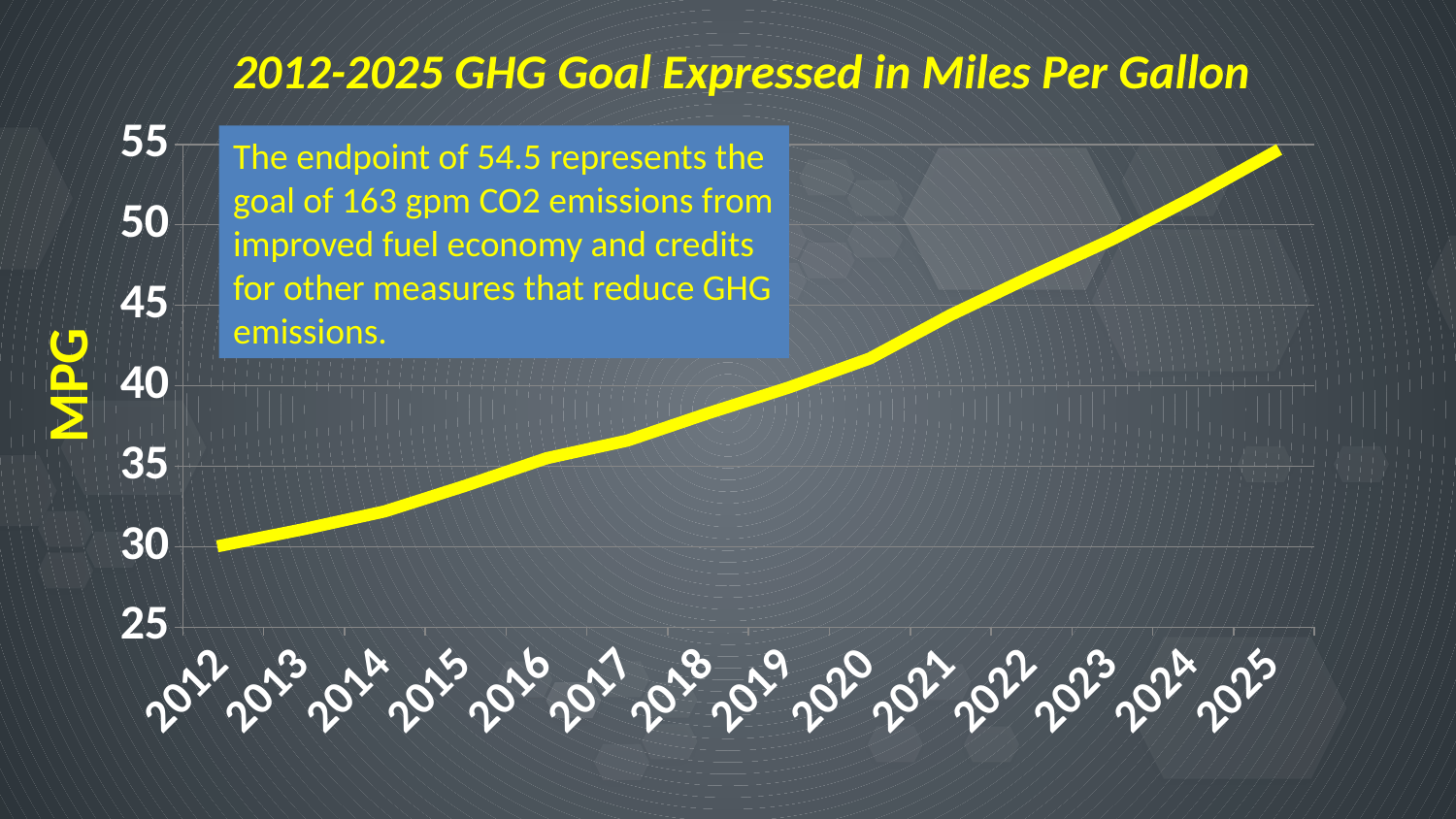
Which year has the lowest MPG value? 2012 Do the MPG values rise or fall from 2012 to 2025? rise How many years are plotted along the x axis? 14 What is the label on the vertical axis? MPG Is the MPG value for 2022 greater or less than 45? greater What kind of chart is shown on the slide? line chart Is the MPG value for 2014 greater or less than 35? less Is the MPG value for 2018 greater or less than 40? less What is the title of the chart? 2012-2025 GHG Goal Expressed in Miles Per Gallon Which year has the highest MPG value? 2025 What is the MPG value at the 2025 endpoint of the line? 54.5 Which year has the larger MPG value, 2016 or 2023? 2023